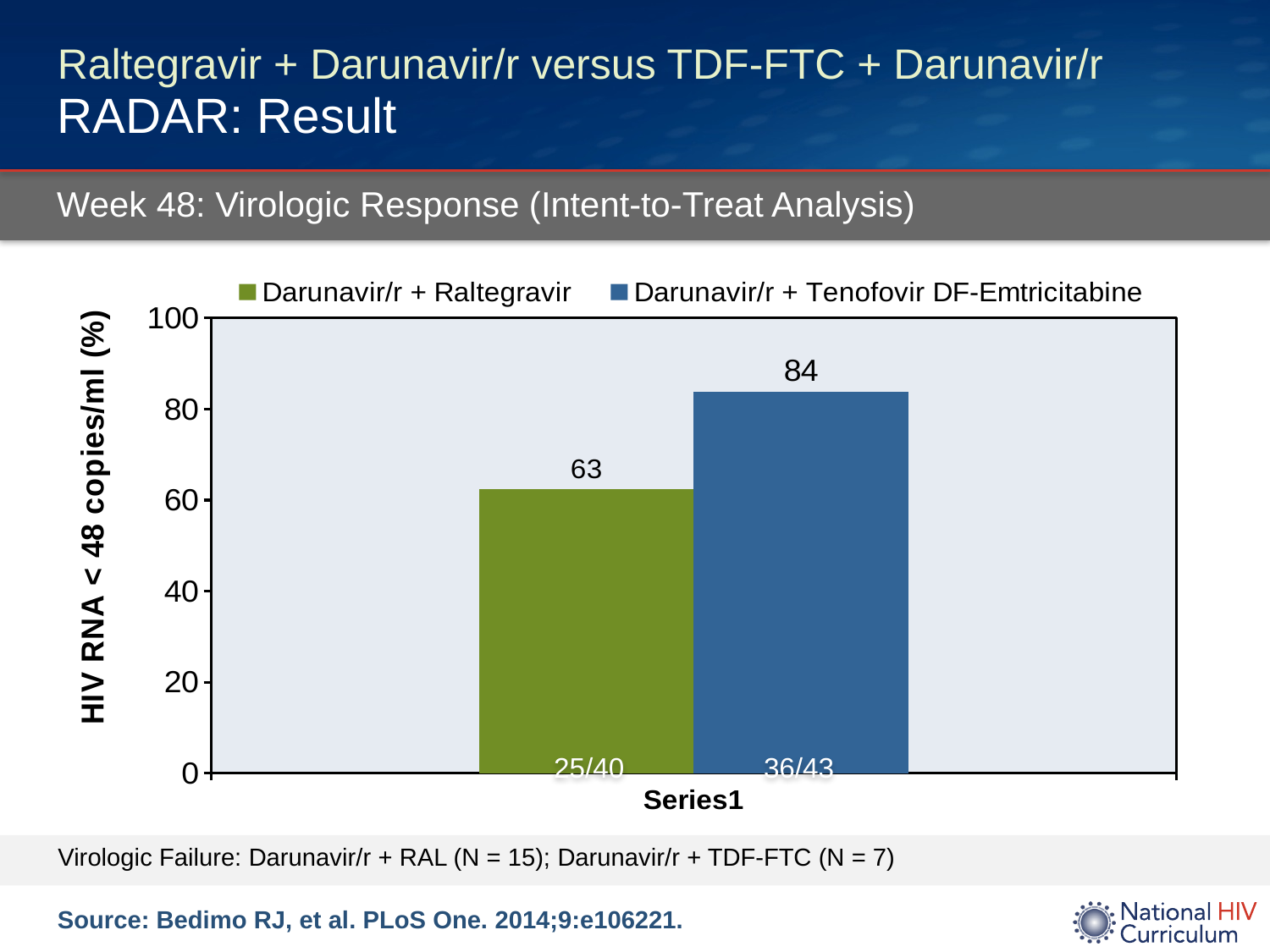
Is the value for Darunavir/r + Raltegravir greater or less than 80? less How many series does the legend list? 2 What kind of chart is shown on the slide? bar chart What is the label of the y axis? HIV RNA < 48 copies/ml (%) Which series has the highest value? Darunavir/r + Tenofovir DF-Emtricitabine What is the difference between the values for Darunavir/r + Tenofovir DF-Emtricitabine and Darunavir/r + Raltegravir? 21 What is the value for Darunavir/r + Tenofovir DF-Emtricitabine? 84 Is the value for Darunavir/r + Tenofovir DF-Emtricitabine greater or less than 80? greater Which series has the lowest value? Darunavir/r + Raltegravir What fraction is printed at the base of the Darunavir/r + Raltegravir bar? 25/40 Which is larger, the value for Darunavir/r + Raltegravir or the value for Darunavir/r + Tenofovir DF-Emtricitabine? Darunavir/r + Tenofovir DF-Emtricitabine What is the value for Darunavir/r + Raltegravir? 63